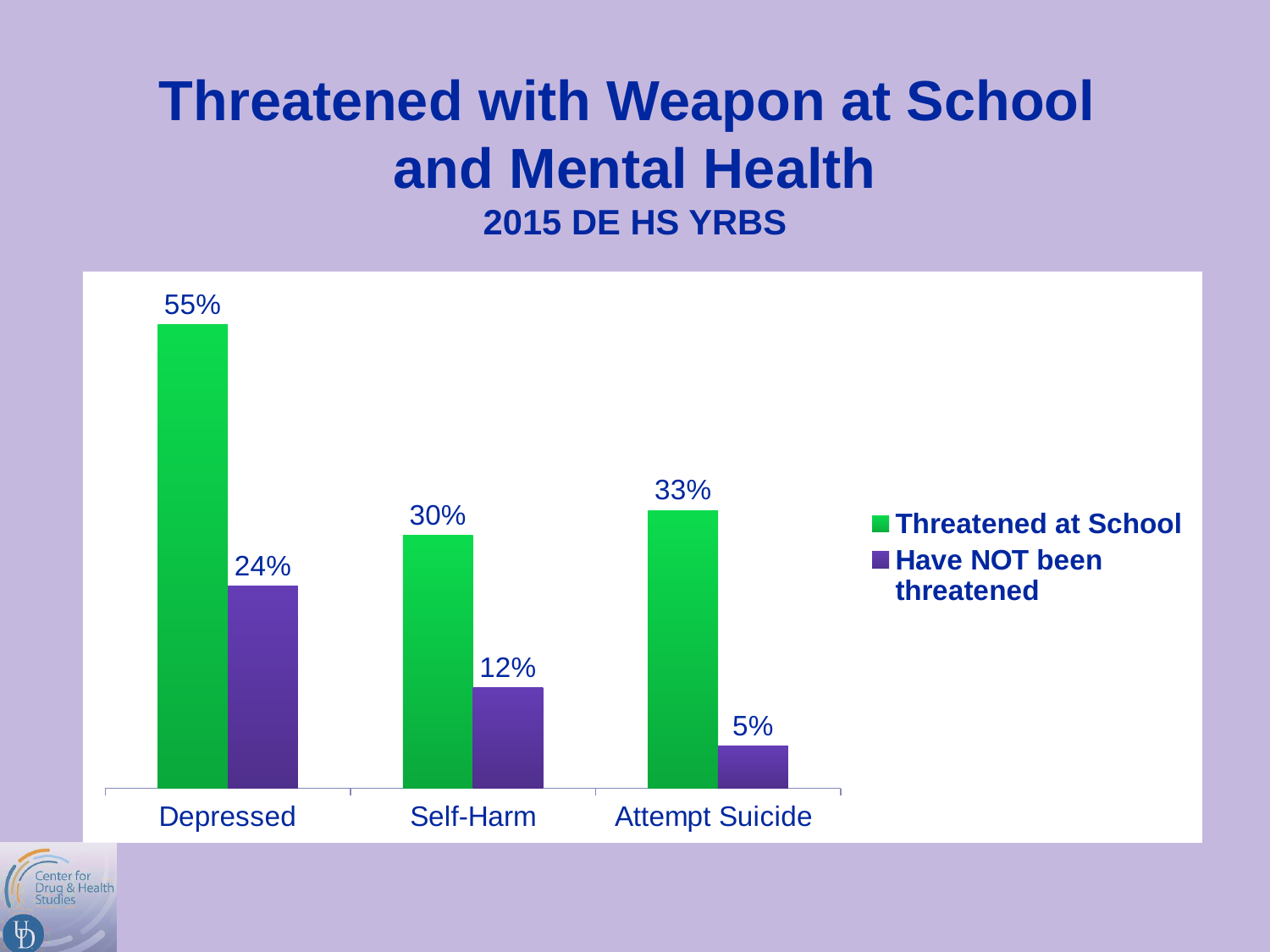
Which category has the highest value in the Threatened at School series? Depressed What kind of chart is shown on the slide? Bar chart How many categories are shown on the x axis? 3 Which category has the lowest value in the Have NOT been threatened series? Attempt Suicide What colour are the bars for the Have NOT been threatened series? Purple What is the value for Attempt Suicide in the Threatened at School series? 33% What is the value for Depressed in the Threatened at School series? 55% What is the value for Self-Harm in the Have NOT been threatened series? 12% Which is larger: the Threatened at School value for Self-Harm or the Threatened at School value for Attempt Suicide? Attempt Suicide What is the difference between the Threatened at School and Have NOT been threatened values for Attempt Suicide? 28% How many series does the legend list? 2 What is the difference between the Threatened at School and Have NOT been threatened values for Depressed? 31%